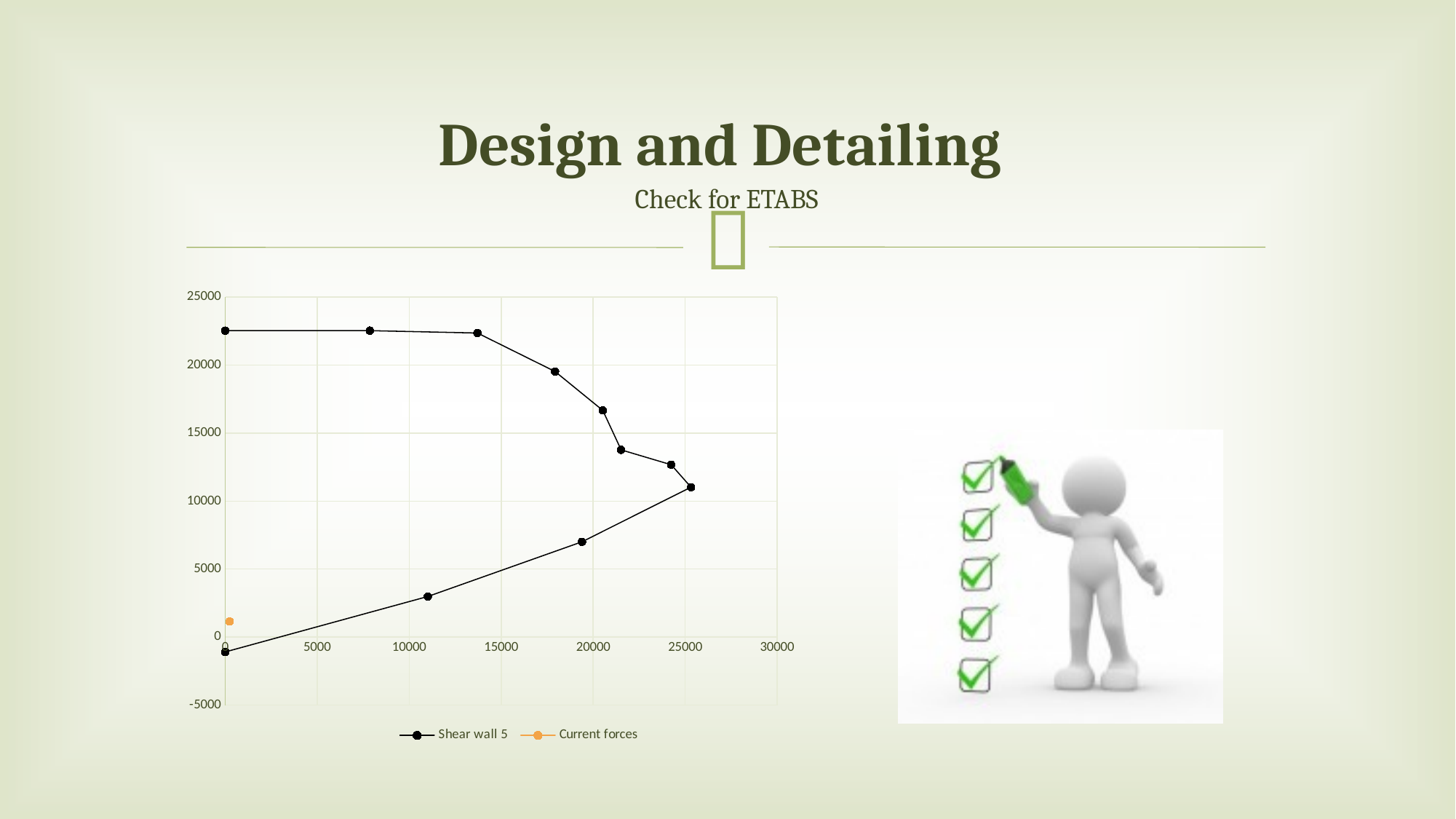
How many data points are plotted for the Shear wall 5 series? 11 What is the maximum value shown on the horizontal axis of the chart? 30000 Is the vertical-axis value of the Current forces point greater or less than 5000? less Which series is drawn in orange in the chart? Current forces Is the horizontal-axis value of the Current forces point greater or less than 5000? less What are the names of the two series in the chart legend? Shear wall 5 and Current forces Is the highest vertical-axis value reached by the Shear wall 5 series greater or less than 20000? greater What kind of chart is shown on the slide? scatter chart How many data points are plotted for the Current forces series? 1 How many series does the chart legend list? 2